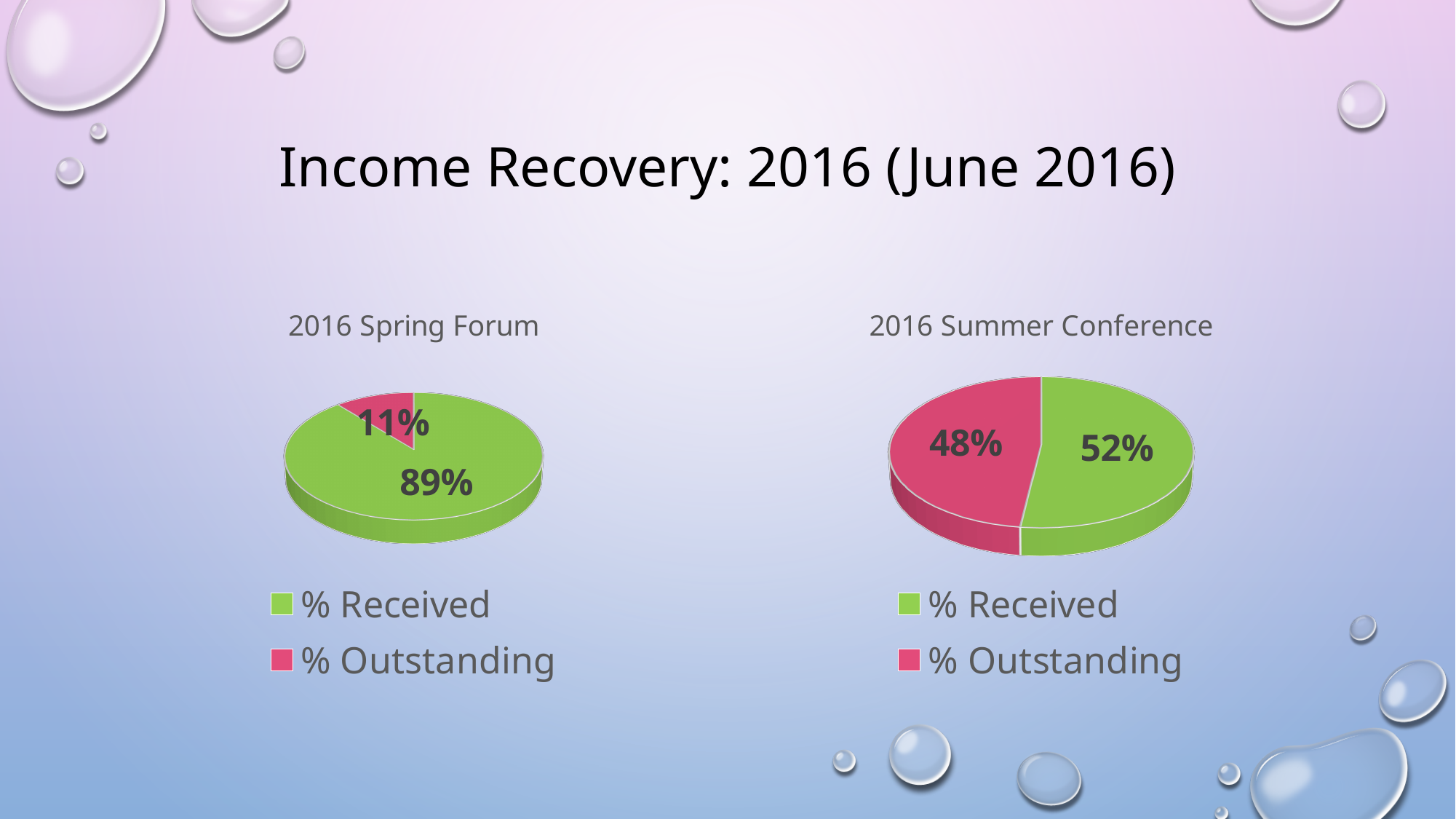
Which chart has the larger % Outstanding slice, 2016 Spring Forum or 2016 Summer Conference? 2016 Summer Conference In the 2016 Summer Conference chart, what is the value for % Received? 52% In the 2016 Summer Conference chart, what is the difference between % Received and % Outstanding? 4% In the 2016 Summer Conference chart, what colour is the % Outstanding slice? Pink In the 2016 Summer Conference chart, which slice is the smallest? % Outstanding In the 2016 Summer Conference chart, what is the value for % Outstanding? 48% In the 2016 Spring Forum chart, what is the value for % Received? 89% In the 2016 Spring Forum chart, which slice is the largest? % Received What kind of chart is the 2016 Spring Forum chart? Pie chart In the 2016 Spring Forum chart, what is the difference between % Received and % Outstanding? 78% In the 2016 Spring Forum chart, what is the value for % Outstanding? 11% How many slices does the 2016 Summer Conference chart have? 2